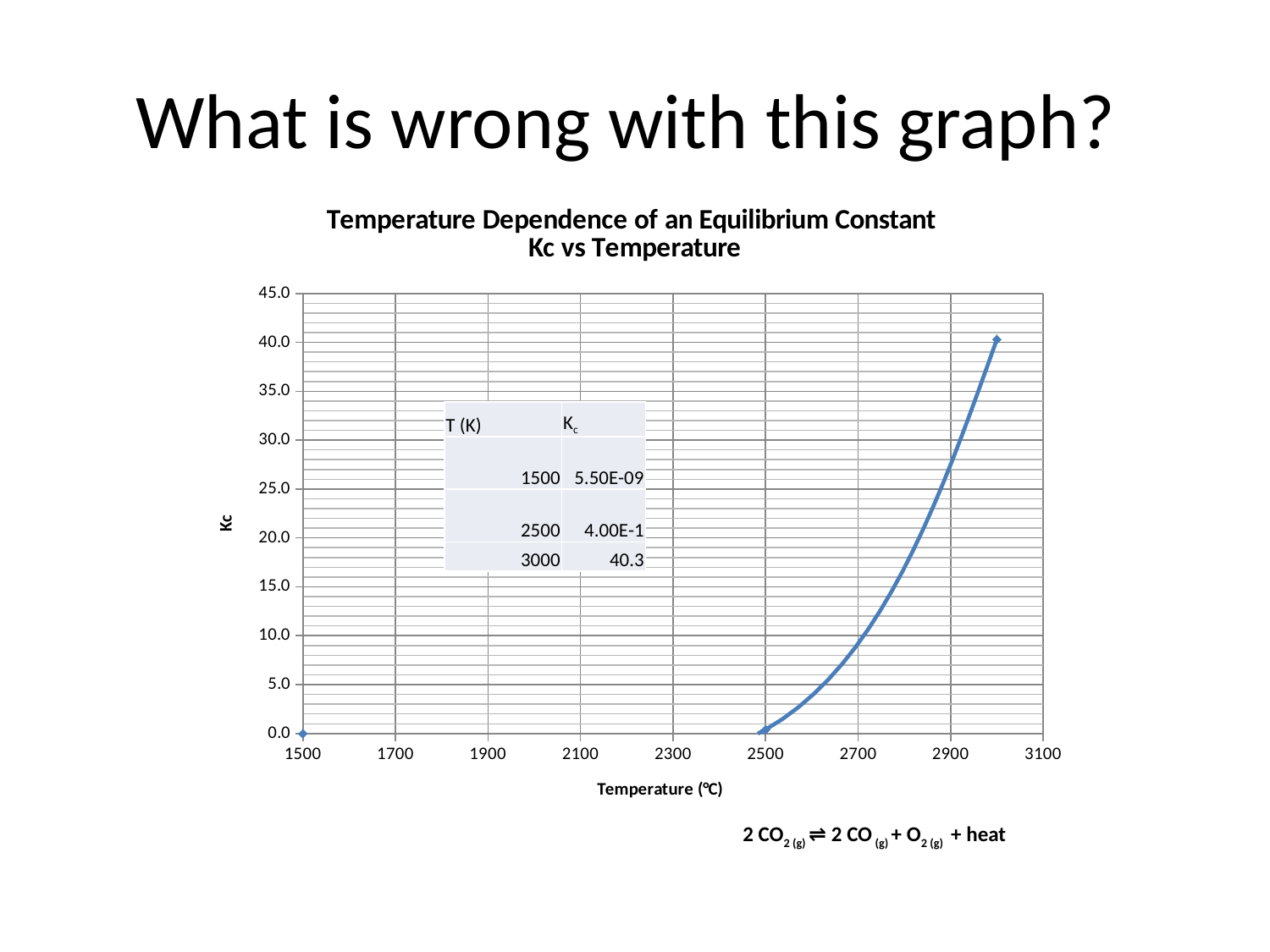
Is the Kc value at 2500 greater or less than 5.0? less At which temperature is Kc highest? 3000 At which temperature is Kc lowest? 1500 What kind of chart is shown on the slide? line chart According to the table on the chart, what is Kc at T = 1500 K? 5.50E-09 Is the Kc value at 3000 greater or less than 35.0? greater What is the label on the x axis of the chart? Temperature (°C) How many data points are plotted on the chart? 3 Which has the larger Kc value, T = 2500 or T = 3000? 3000 According to the table on the chart, what is Kc at T = 2500 K? 4.00E-1 Does Kc rise or fall as temperature increases along the x axis? rises According to the table on the chart, what is Kc at T = 3000 K? 40.3